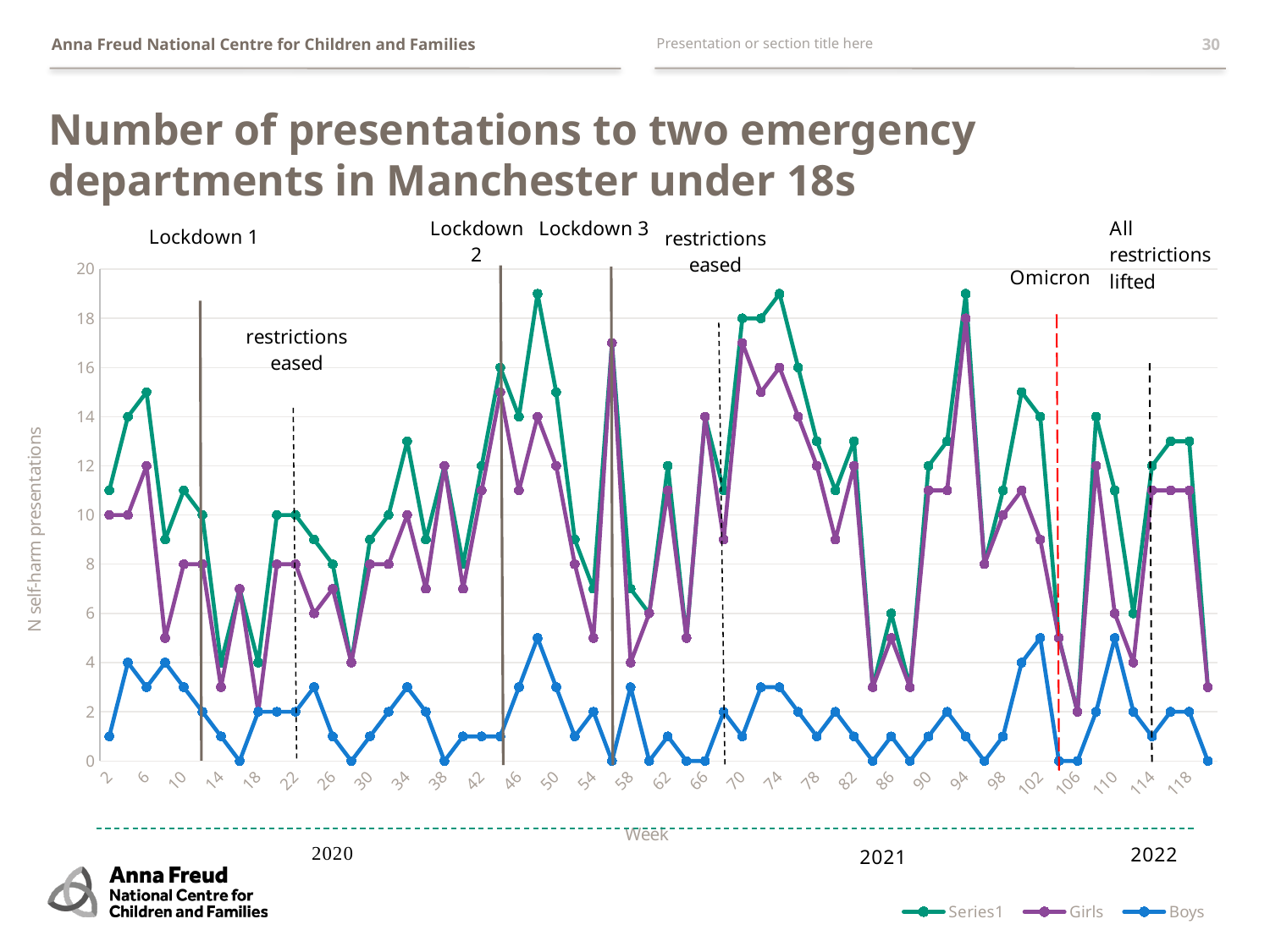
Is the value for Boys at week 2 greater or less than 2? less Is the value for Girls at week 2 greater or less than 8? greater Which series reaches the highest value anywhere on the chart? Series1 What are the three series named in the legend? Series1, Girls, Boys Between week 2 and week 4, does the Boys line rise or fall? rise What is the title of the vertical axis? N self-harm presentations Which series has the lowest values across the chart? Boys What type of chart is shown on the slide? line chart Is the highest value reached by the Boys series greater or less than 6? less At week 2, which is larger, the Girls value or the Boys value? Girls How many series does the legend list? 3